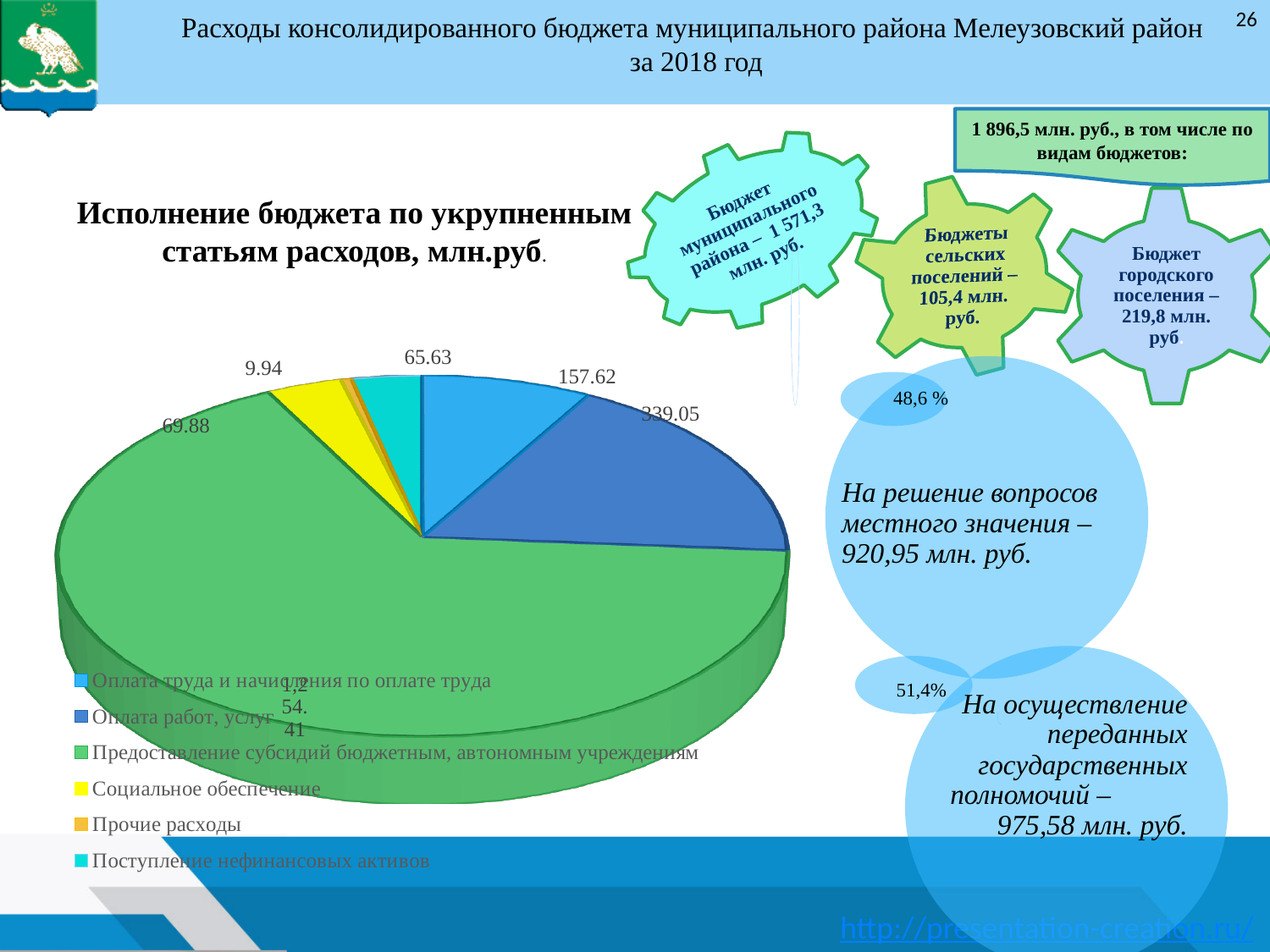
Which category has the largest slice in the pie chart? Предоставление субсидий бюджетным, автономным учреждениям What is the value for 'Поступление нефинансовых активов' in the pie chart? 65.63 What kind of chart is shown on the slide? Pie chart What is the difference between the values for 'Оплата работ, услуг' and 'Оплата труда и начисления по оплате труда'? 181.43 How many categories does the legend of the pie chart list? 6 What is the value for 'Социальное обеспечение' in the pie chart? 69.88 What is the value for 'Оплата труда и начисления по оплате труда' in the pie chart? 157.62 What is the value for 'Прочие расходы' in the pie chart? 9.94 What colour is the slice for 'Социальное обеспечение' in the pie chart? Yellow Which is larger: the value for 'Социальное обеспечение' or for 'Поступление нефинансовых активов'? Социальное обеспечение What is the value for 'Оплата работ, услуг' in the pie chart? 339.05 Which category has the smallest slice in the pie chart? Прочие расходы